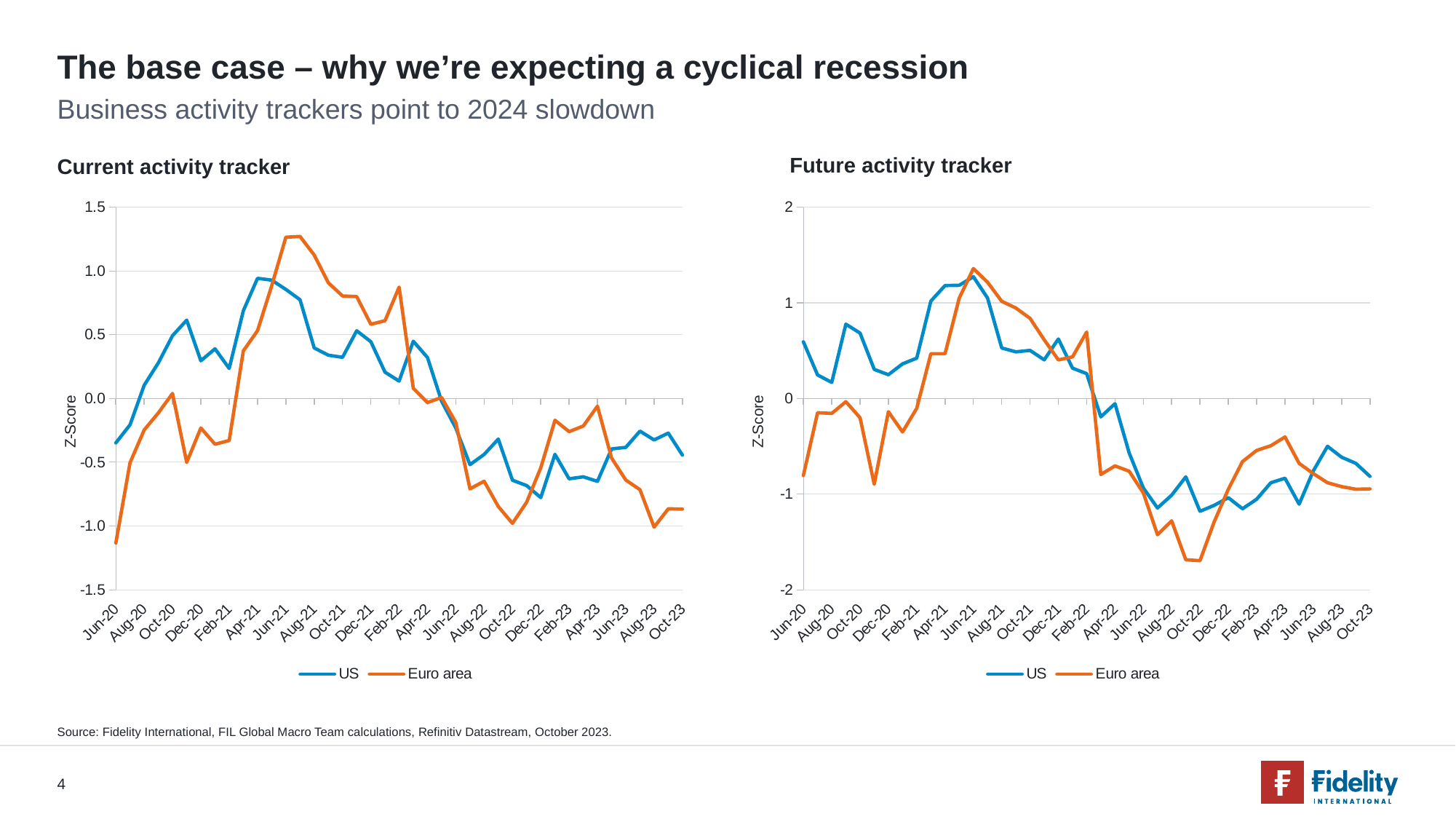
In the Current activity tracker chart, is the Euro area value at Jun-20 greater or less than -1.0? less What type of chart is the Current activity tracker? Line chart In the Current activity tracker chart, does the US series generally rise or fall from Jun-21 to Oct-22? Fall What is the y-axis label on the Current activity tracker chart? Z-Score In the Future activity tracker chart, which series is higher at Oct-22, US or Euro area? US How many series does the legend of the Future activity tracker chart list? 2 In the Future activity tracker chart, is the US value at Jun-20 greater or less than 0? greater In the Current activity tracker chart, which series is higher at Jun-20, US or Euro area? US In the Current activity tracker chart, is the peak Euro area value around Jun-21 greater or less than 1.0? greater Which two series are shown in the legend of the Current activity tracker chart? US and Euro area In the Current activity tracker chart, which series reaches the lowest point over the whole period? Euro area